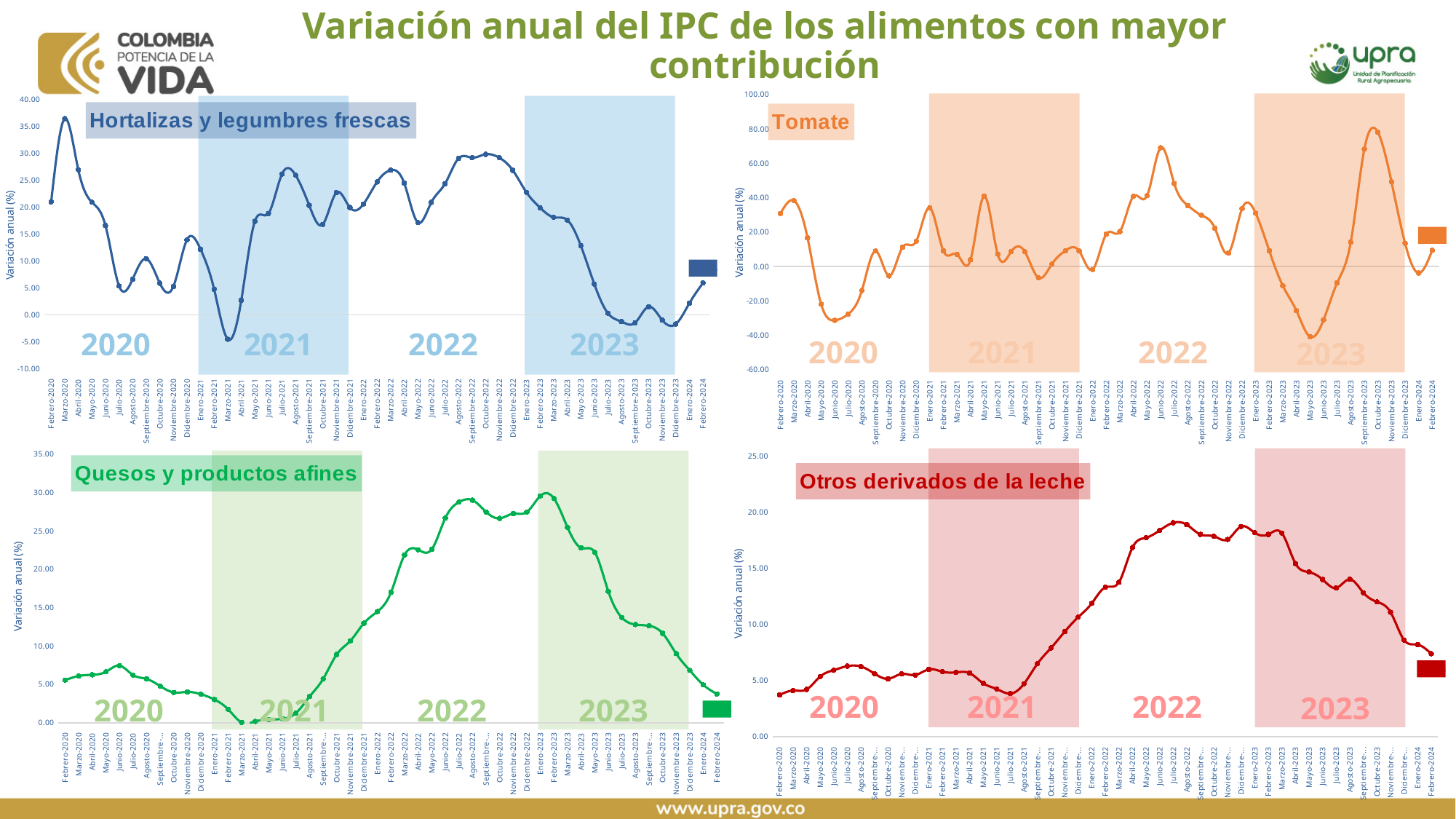
In the 'Tomate' chart, is the value for Octubre-2023 greater or less than 60.00? greater In the 'Hortalizas y legumbres frescas' chart, is the value for Marzo-2020 greater or less than 35.00? greater In the 'Otros derivados de la leche' chart, do the values rise or fall from Julio-2022 to Febrero-2024? fall In the 'Otros derivados de la leche' chart, is the value for Febrero-2024 greater or less than 10.00? less What is the label on the vertical axis of the 'Tomate' chart? Variación anual (%) What kind of chart is the 'Hortalizas y legumbres frescas' chart? line chart In the 'Quesos y productos afines' chart, do the values rise or fall from Febrero-2023 to Febrero-2024? fall